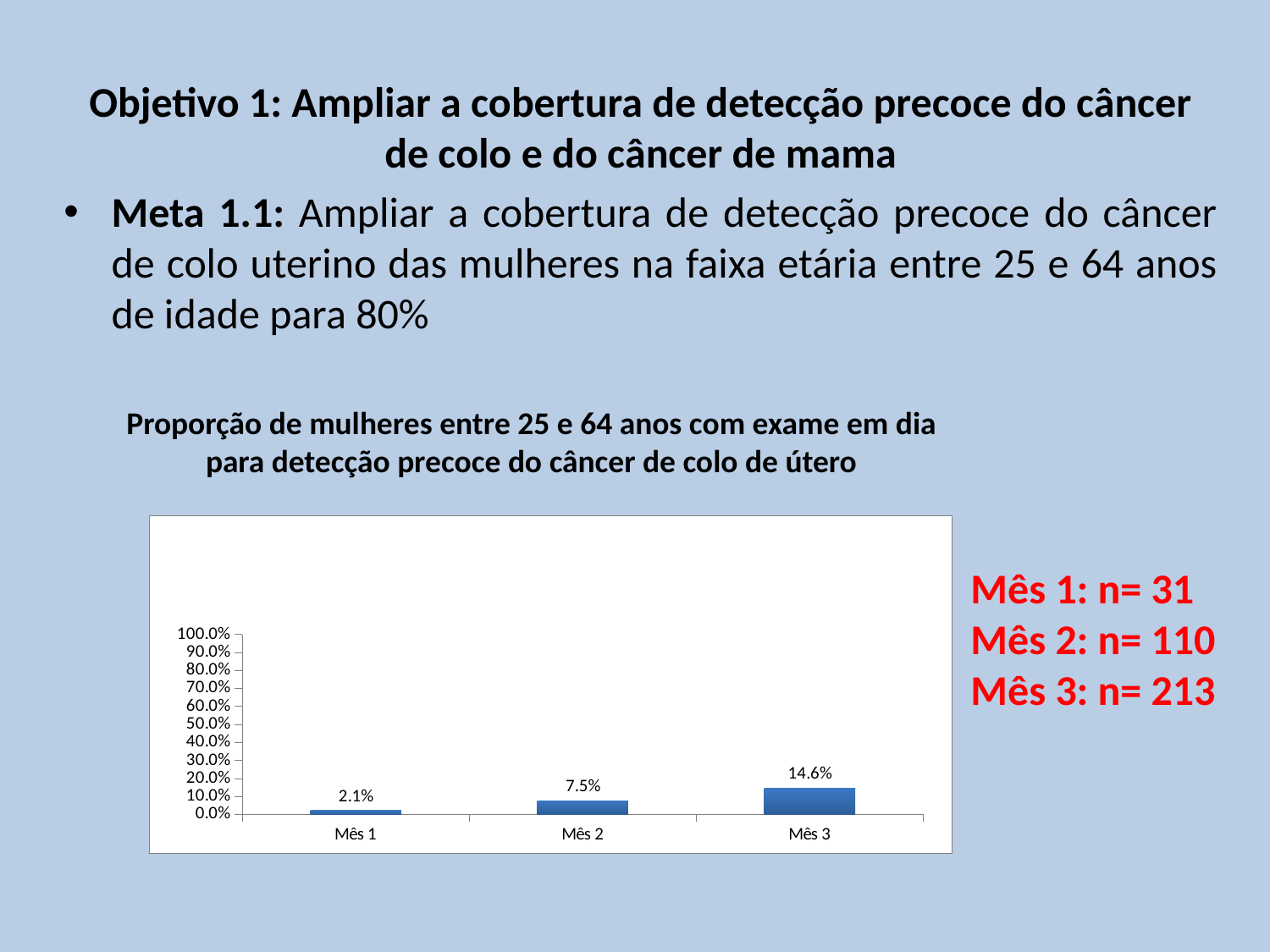
What kind of chart is shown on the slide? bar chart What is the value for Mês 1? 2.1% Which month has the lowest value? Mês 1 Is the value for Mês 3 greater or less than 20%? less What is the value for Mês 2? 7.5% Do the values rise or fall from Mês 1 to Mês 3? rise Which is larger, the value for Mês 2 or the value for Mês 3? Mês 3 What is the value for Mês 3? 14.6% What is the difference between the values for Mês 3 and Mês 1? 12.5% How many months are shown on the x axis? 3 Which month has the highest value? Mês 3 What is the difference between the values for Mês 2 and Mês 1? 5.4%